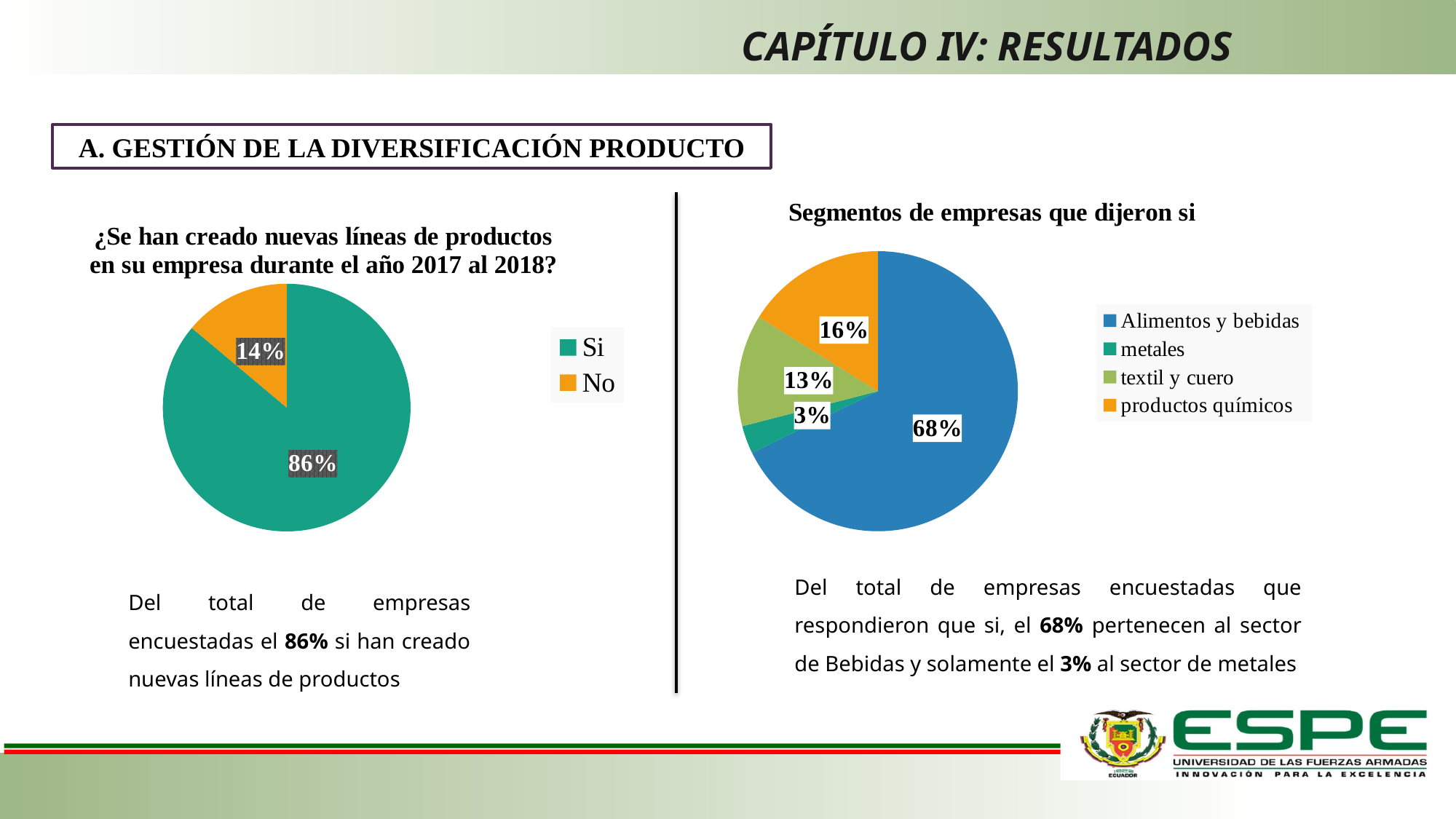
What type of chart is the chart titled 'Segmentos de empresas que dijeron si'? Pie chart In the chart 'Segmentos de empresas que dijeron si', which is larger: textil y cuero or productos químicos? productos químicos In the left pie chart (¿Se han creado nuevas líneas de productos...?), which answer has the larger share? Si In the left pie chart (¿Se han creado nuevas líneas de productos...?), what share of companies answered Si? 86% In the chart 'Segmentos de empresas que dijeron si', which segment has the smallest share? metales In the left pie chart (¿Se han creado nuevas líneas de productos...?), what share of companies answered No? 14% In the left pie chart (¿Se han creado nuevas líneas de productos...?), how many slices does the pie have? 2 In the left pie chart (¿Se han creado nuevas líneas de productos...?), what is the difference between the Si and No shares? 72% In the chart 'Segmentos de empresas que dijeron si', what share is Alimentos y bebidas? 68% In the chart 'Segmentos de empresas que dijeron si', what share is productos químicos? 16% In the chart 'Segmentos de empresas que dijeron si', what share is metales? 3% In the chart 'Segmentos de empresas que dijeron si', how many segments does the legend list? 4